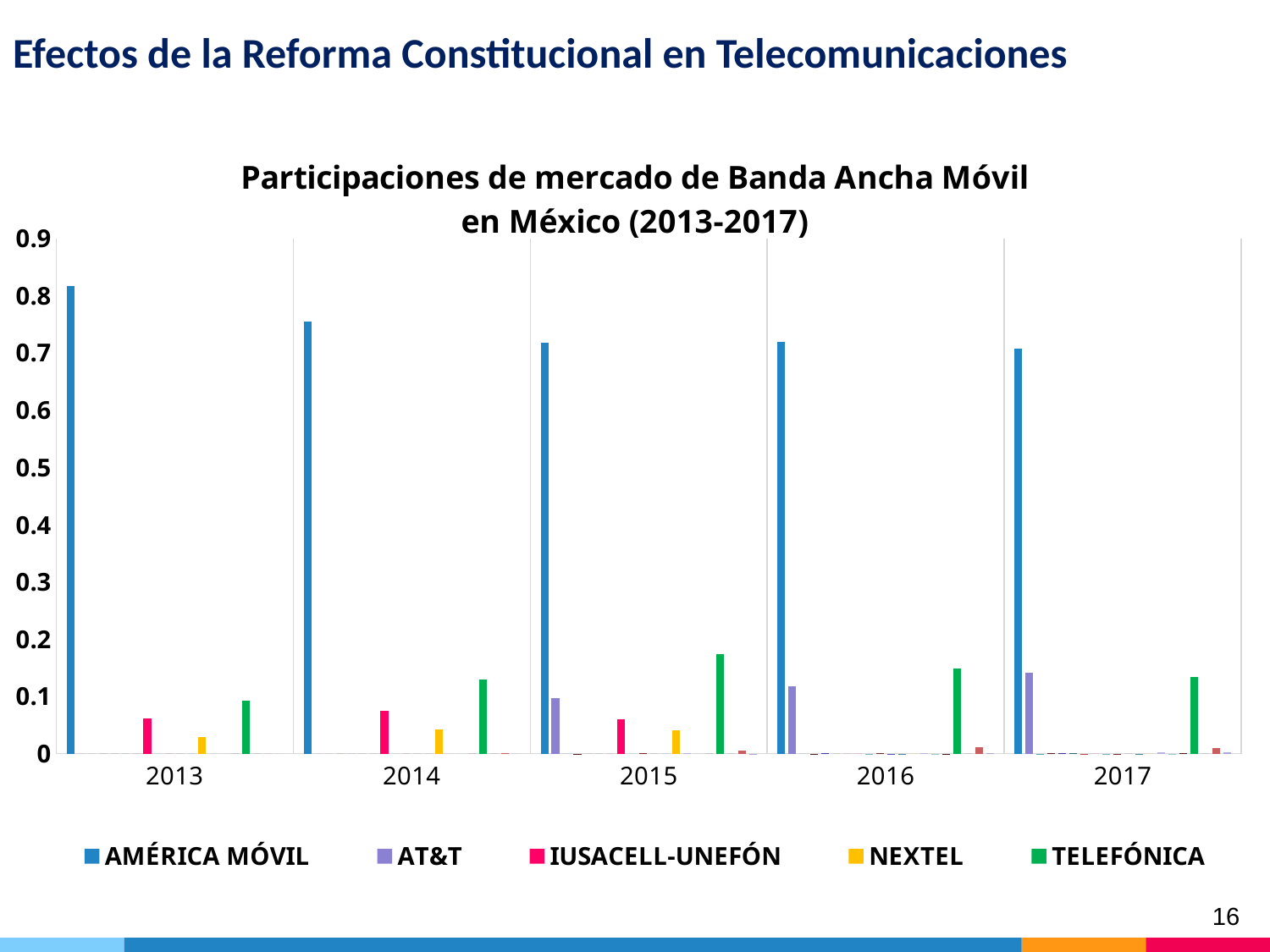
Is the value for TELEFÓNICA in 2015 greater or less than 0.2? less How many years are shown on the x axis? 5 What type of chart is shown on the slide? bar chart Which series is shown in green in the legend? TELEFÓNICA Is the value for NEXTEL in 2013 greater or less than 0.1? less Is the value for AMÉRICA MÓVIL in 2013 greater or less than 0.8? greater In which year is the AMÉRICA MÓVIL bar the highest? 2013 Which is larger in 2015, the value for AT&T or the value for TELEFÓNICA? TELEFÓNICA How many series does the legend list? 5 In which year is the TELEFÓNICA bar the highest? 2015